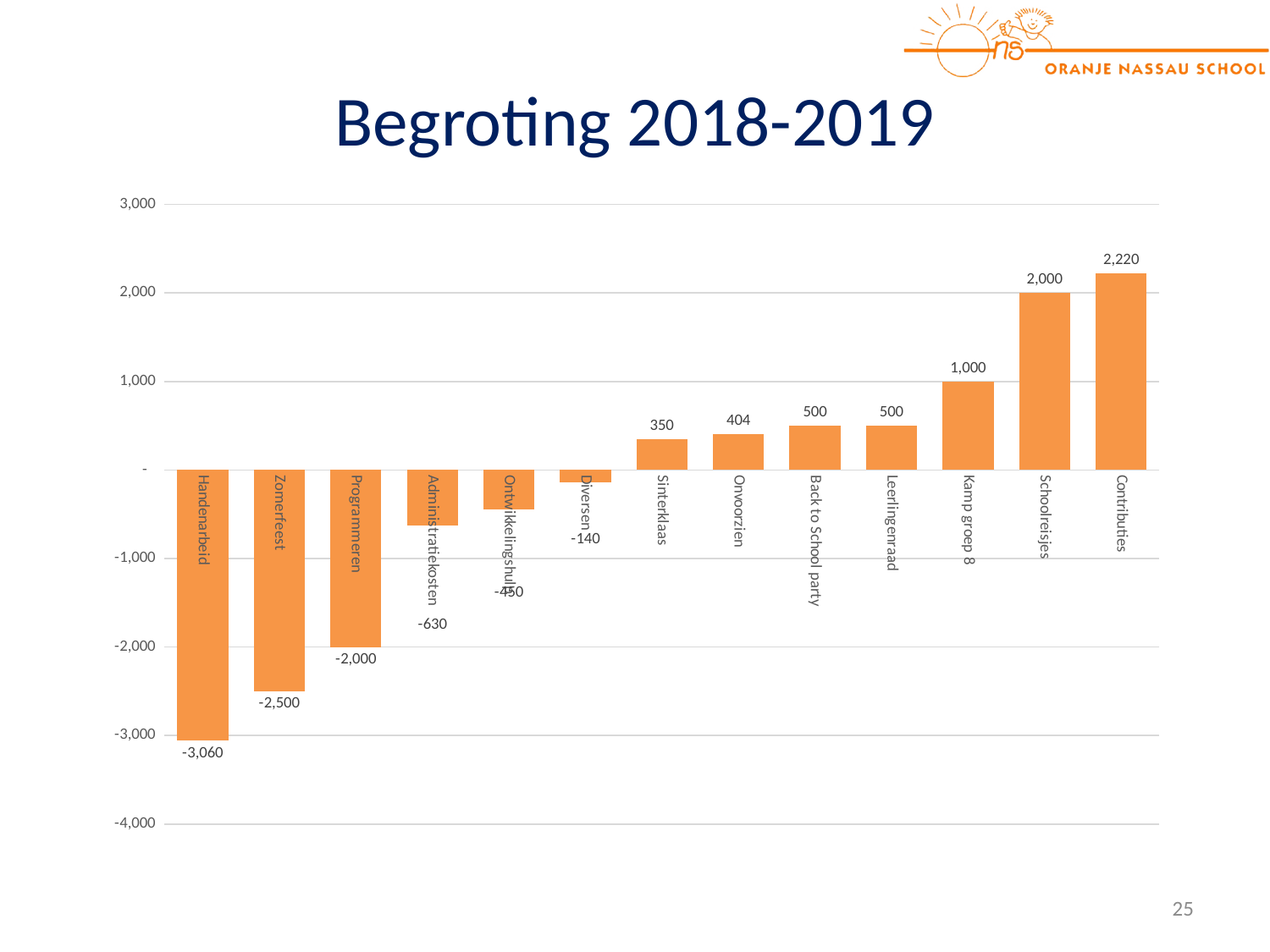
Which category has the lowest value? Handenarbeid What is the value for Handenarbeid? -3,060 What is the value for Onvoorzien? 404 What is the value for Kamp groep 8? 1,000 Which category has the highest value? Contributies What kind of chart is shown on the slide? Bar chart What is the difference between the values for Zomerfeest and Programmeren? 500 How many categories are shown in the chart? 13 What is the title of the slide? Begroting 2018-2019 Which is larger, the value for Sinterklaas or the value for Onvoorzien? Onvoorzien What is the difference between the values for Contributies and Schoolreisjes? 220 What is the value for Contributies? 2,220